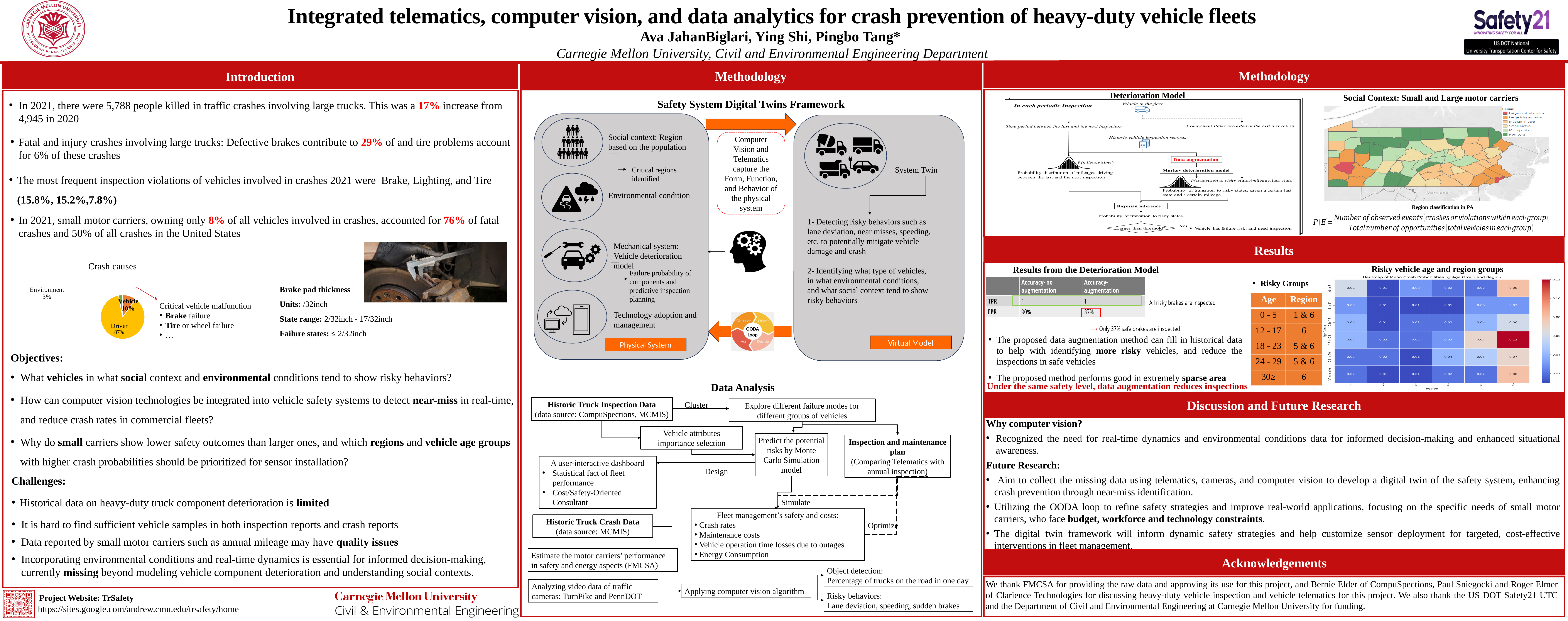
In the "Crash causes" pie chart, what percentage of crashes is attributed to Environment? 3% In the "Crash causes" pie chart, what is the difference in percentage points between the Driver share and the Vehicle share? 77 In the "Crash causes" pie chart, what percentage of crashes is attributed to Vehicle? 10% What is the title of the pie chart in the Introduction section? Crash causes What kind of chart is the "Crash causes" chart in the Introduction section? pie chart In the "Crash causes" pie chart, what is the combined share of Vehicle and Environment? 13% In the "Crash causes" pie chart, which cause has the largest share? Driver In the "Crash causes" pie chart, what percentage of crashes is attributed to Driver? 87% What is the title of the heatmap in the Results section? Heatmap of Mean Crash Probabilities by Age Group and Region In the "Crash causes" pie chart, which cause has the smallest share? Environment In the "Crash causes" pie chart, which is larger: the Vehicle share or the Environment share? Vehicle In the "Crash causes" pie chart, how many categories are shown? 3